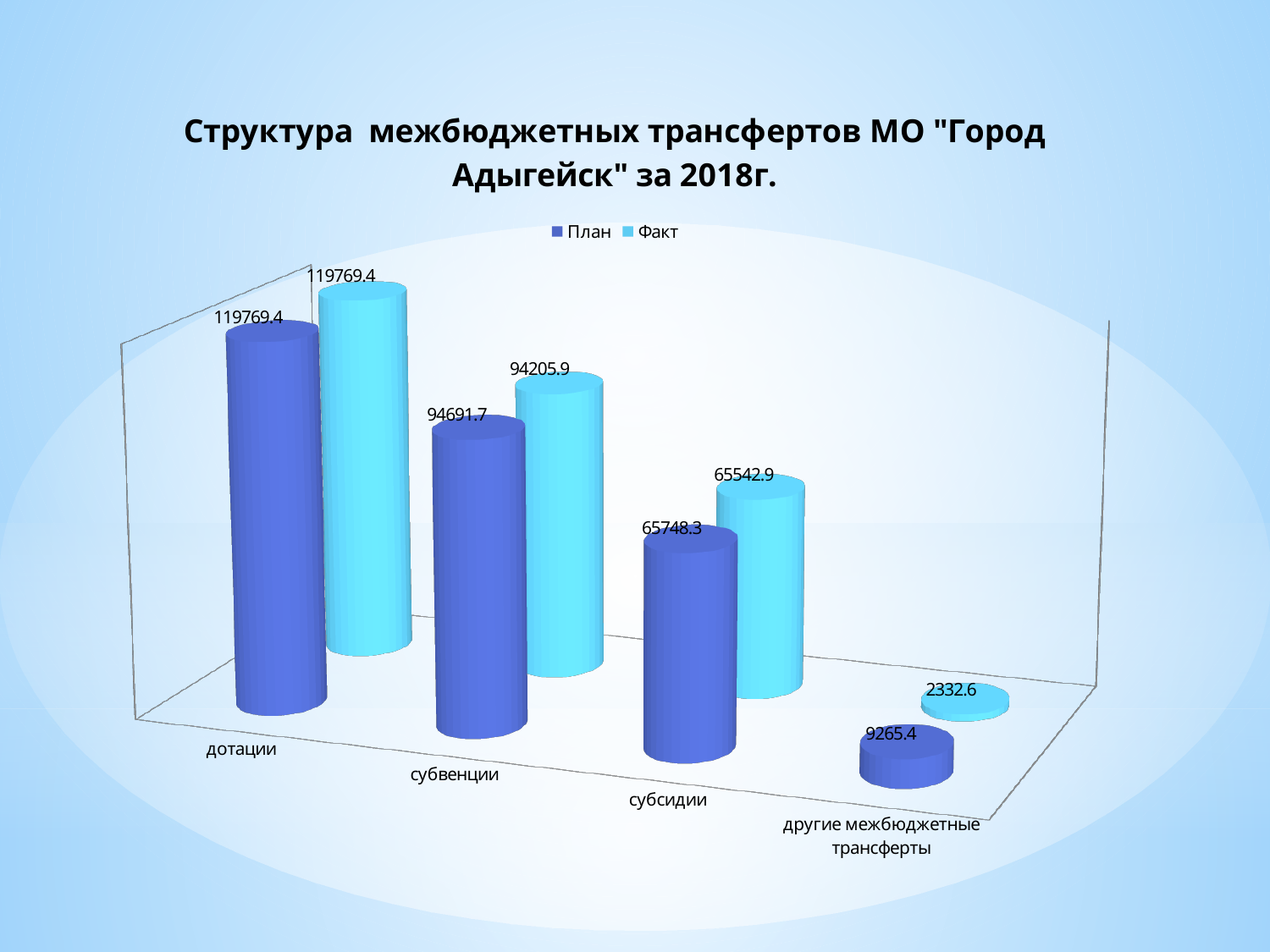
Which category has the highest Факт value? дотации How many series does the legend list? 2 For субсидии, which is larger: the План value or the Факт value? План What is the Факт value for субвенции? 94205.9 How many categories are shown on the x axis? 4 What is the difference between the План and Факт values for субвенции? 485.8 What is the Факт value for другие межбюджетные трансферты? 2332.6 What kind of chart is shown on the slide? bar chart Which category has the lowest План value? другие межбюджетные трансферты What is the План value for дотации? 119769.4 What is the difference between the План and Факт values for другие межбюджетные трансферты? 6932.8 What is the План value for субсидии? 65748.3